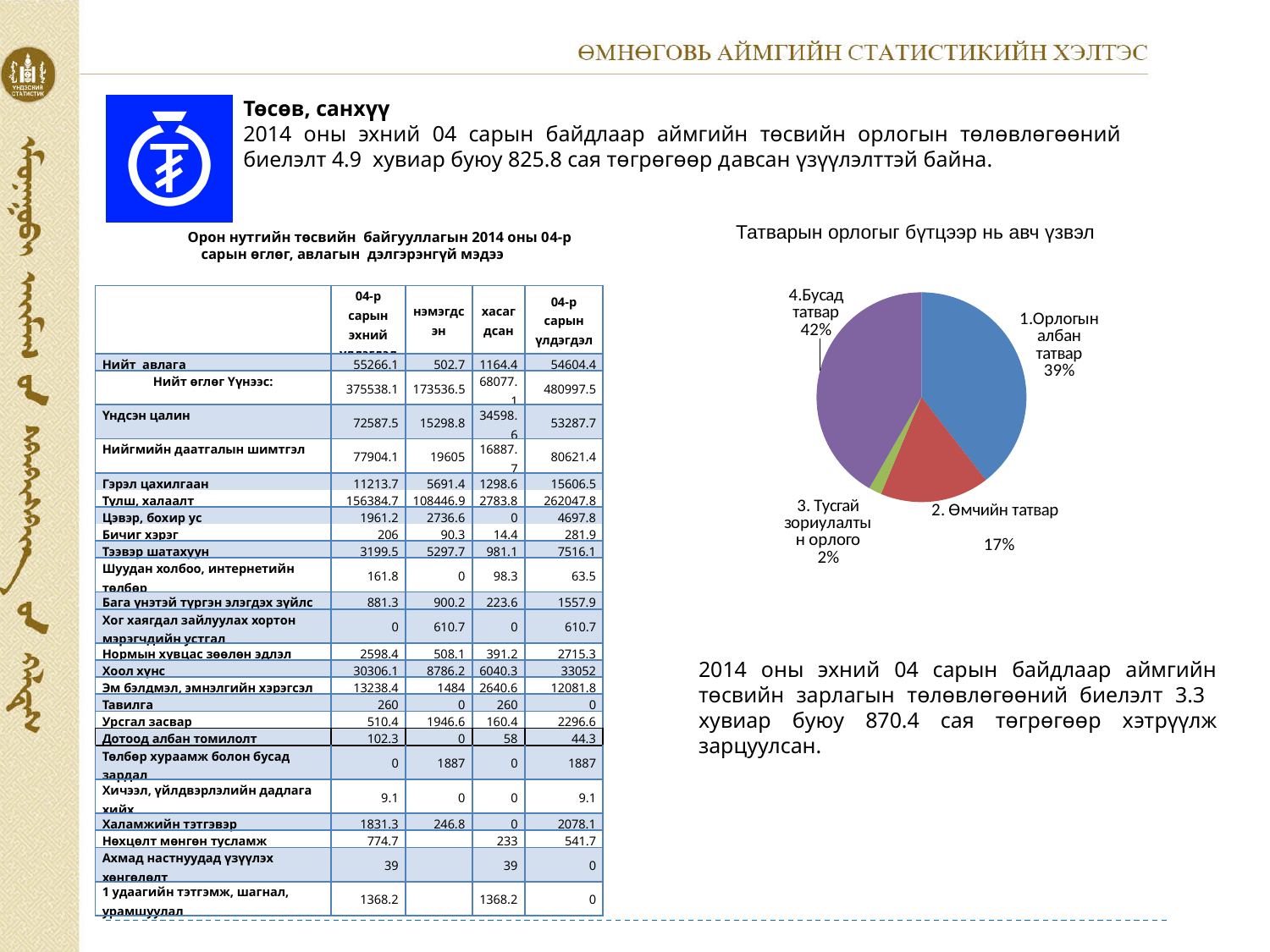
What is the title of the pie chart? Татварын орлогыг бүтцээр нь авч үзвэл What share of the pie does "3. Тусгай зориулалтын орлого" represent? 2% What kind of chart is shown on the slide? pie chart What is the combined share of "1.Орлогын албан татвар" and "2. Өмчийн татвар"? 56% Which is larger in the pie chart: "2. Өмчийн татвар" or "3. Тусгай зориулалтын орлого"? 2. Өмчийн татвар Which slice of the pie chart is the smallest? 3. Тусгай зориулалтын орлого What share of the pie does "2. Өмчийн татвар" represent? 17% What share of the pie does "4.Бусад татвар" represent? 42% Which slice of the pie chart is the largest? 4.Бусад татвар What is the difference in percentage points between "4.Бусад татвар" and "1.Орлогын албан татвар"? 3 How many slices does the pie chart have? 4